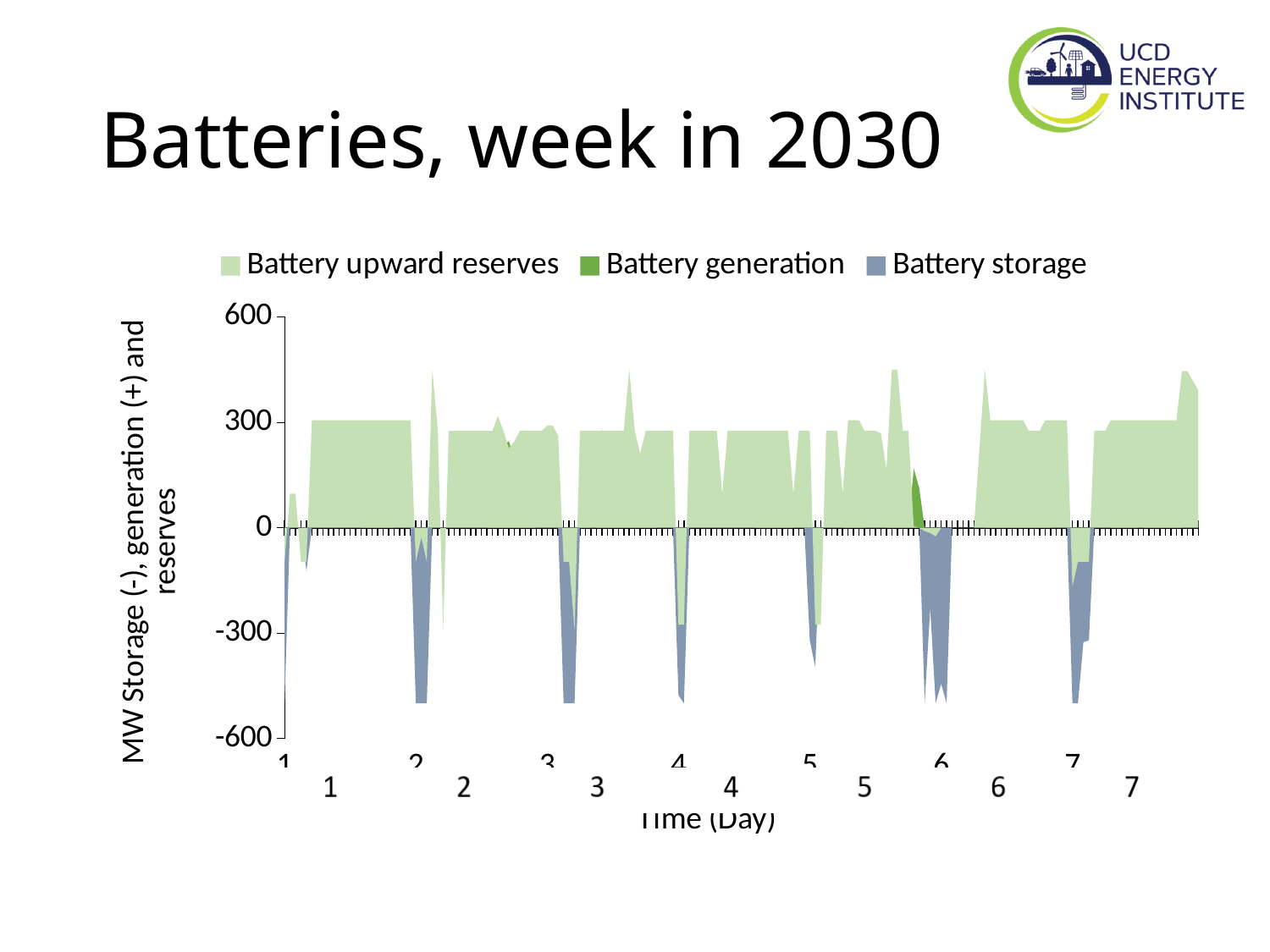
Is the highest value reached by Battery upward reserves greater or less than 600? less How many series does the legend list? 3 What kind of chart is shown on the slide? Area chart What is the title of the slide's chart? Batteries, week in 2030 Is the highest value reached by Battery upward reserves greater or less than 300? greater What is the maximum value shown on the y axis? 600 Is the lowest value reached by Battery storage greater or less than -300? less What is the label of the x axis? Time (Day) How many days are labelled along the x axis? 7